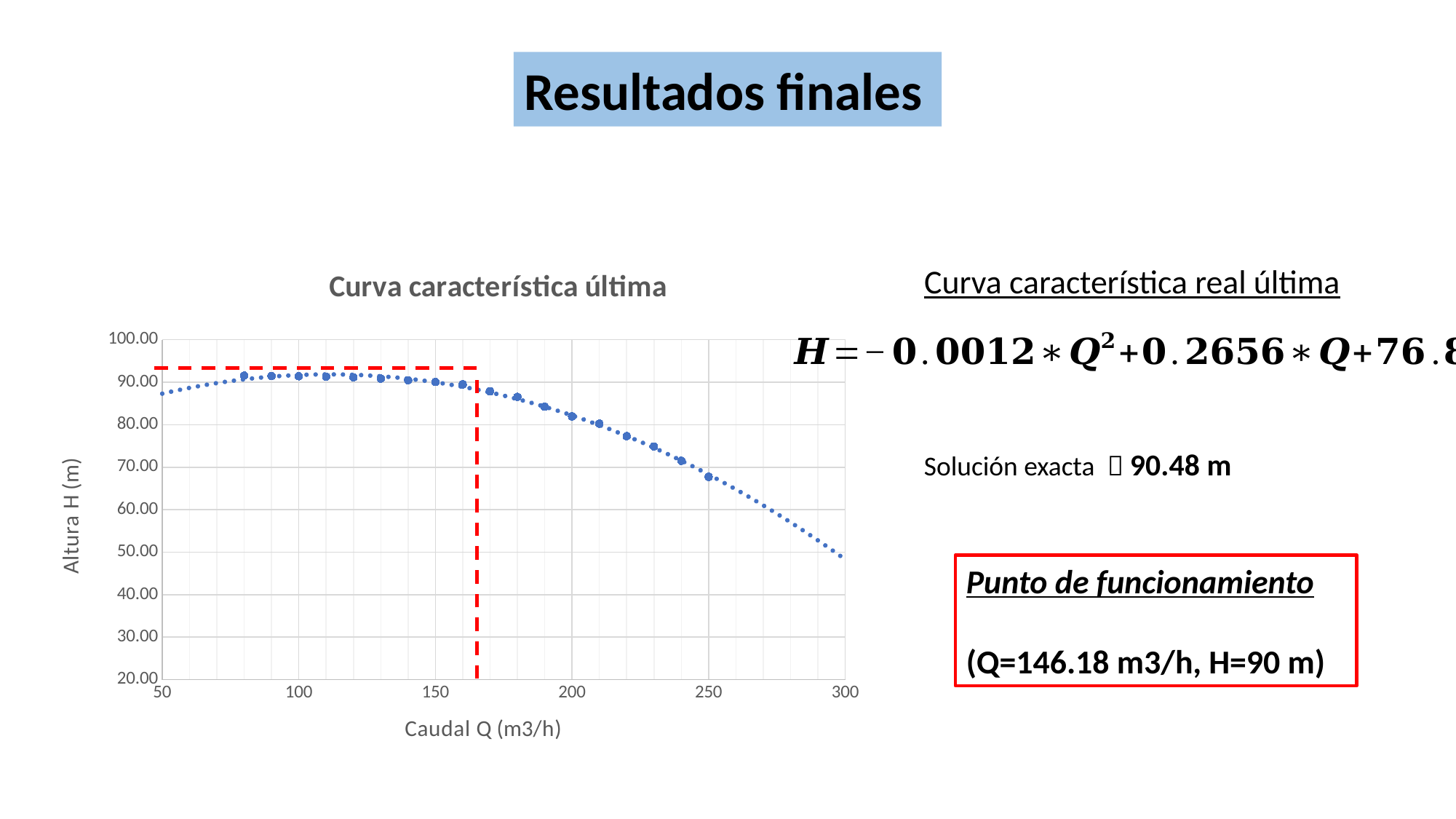
What is the label of the x axis of the chart? Caudal Q (m3/h) In the chart, is the value of H at Q=180 greater or less than 80? greater In the chart, is H larger at Q=100 or at Q=250? Q=100 In the chart, which plotted point has the lowest H value? Q=250 In the chart, is the value of H at Q=220 greater or less than 80? less In the chart, do the H values rise or fall as Q increases from 150 to 250? fall What is the title of the chart on the slide? Curva característica última In the chart, is the value of H at Q=250 greater or less than 80? less What is the highest value shown on the y axis of the chart? 100.00 What kind of chart is "Curva característica última"? scatter chart